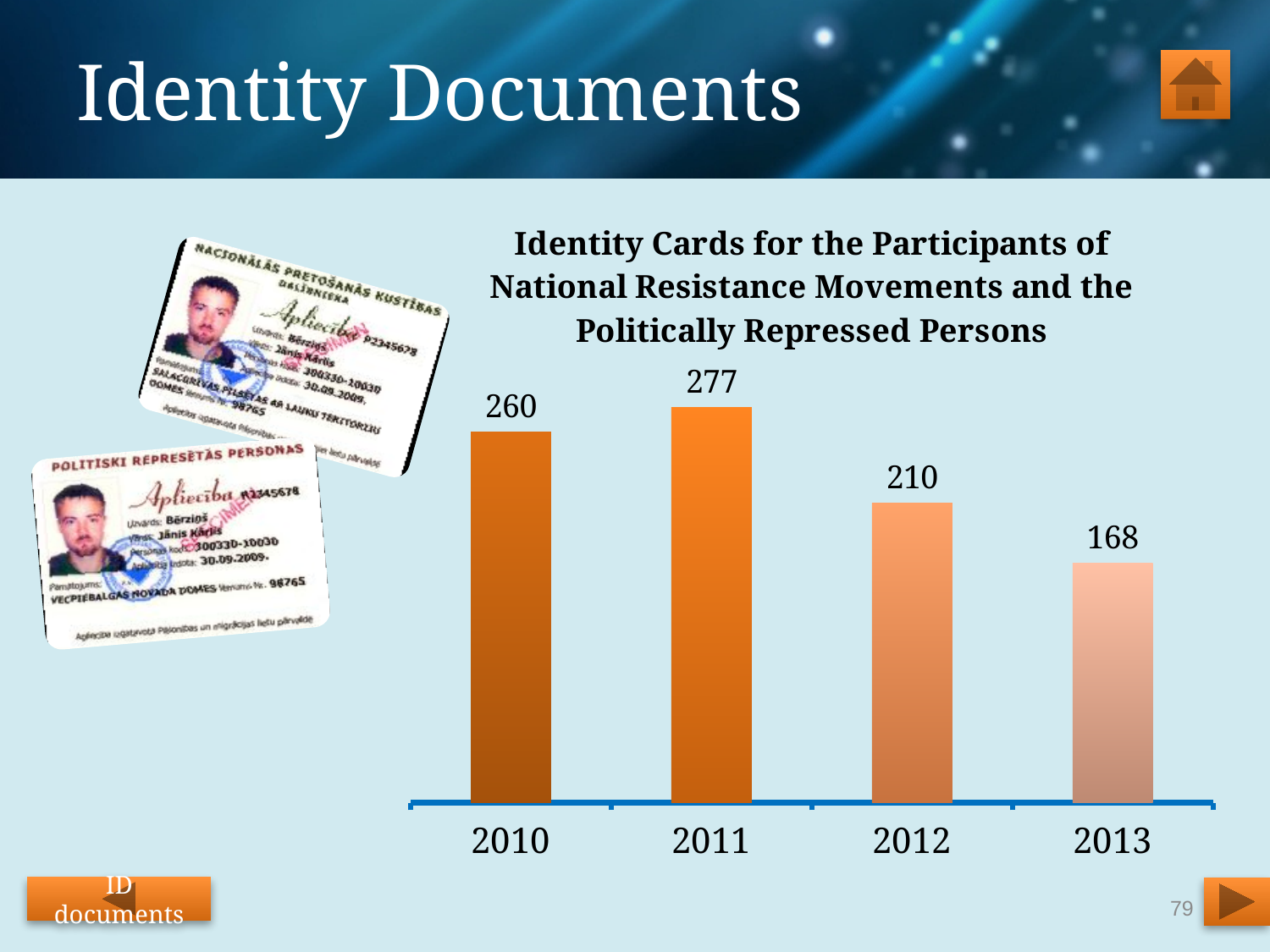
What is the value for 2011? 277 What is the value for 2010? 260 What is the difference between the values for 2011 and 2013? 109 How many years are shown on the chart? 4 What is the title of the chart? Identity Cards for the Participants of National Resistance Movements and the Politically Repressed Persons What kind of chart is shown on the slide? Bar chart What is the difference between the values for 2010 and 2012? 50 Which year has the lowest value? 2013 Which is larger, the value for 2010 or the value for 2012? 2010 What is the value for 2013? 168 What is the value for 2012? 210 Which year has the highest value? 2011